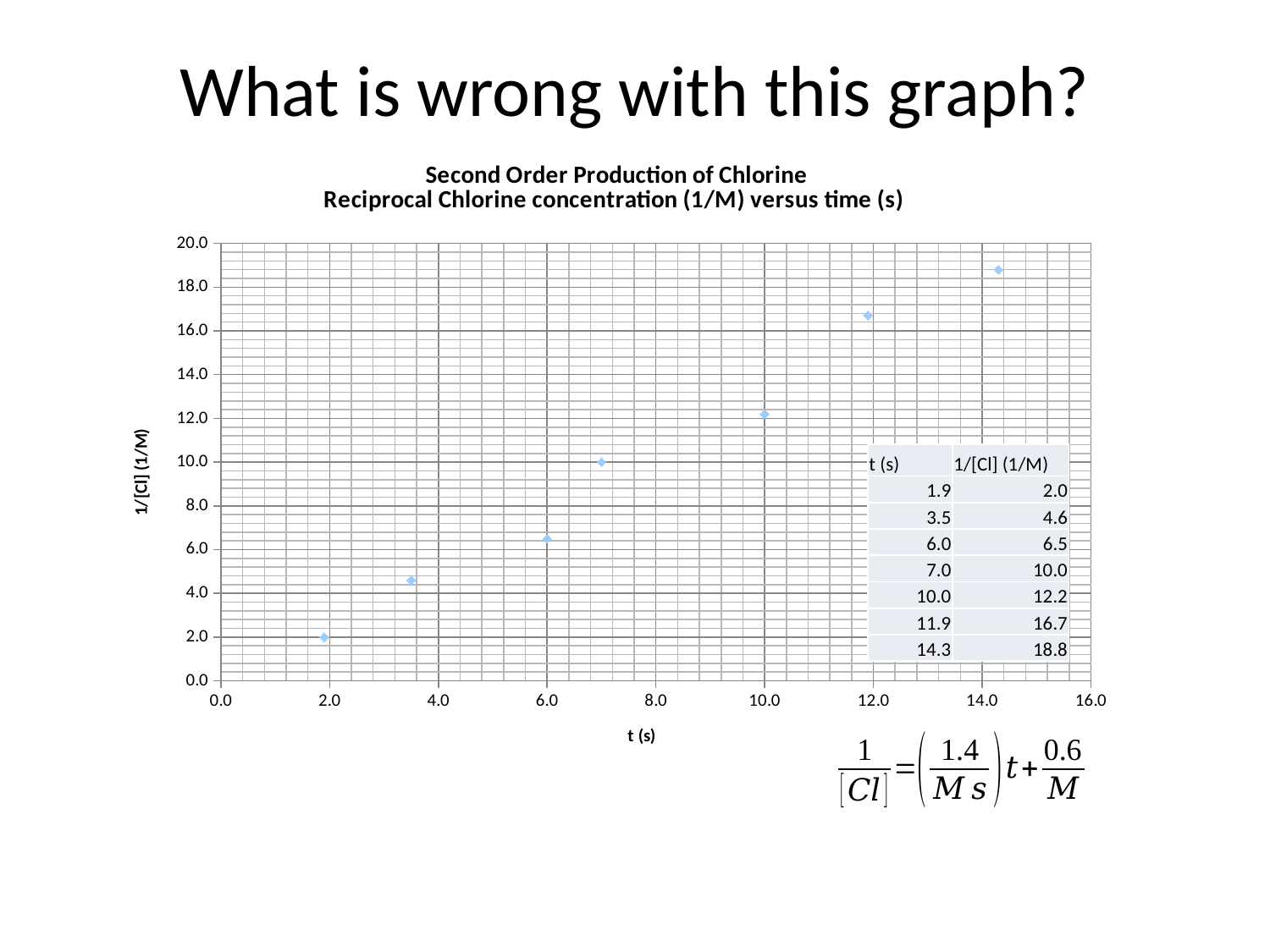
How many data points are plotted on the chart? 7 What is the value of 1/[Cl] (1/M) at t = 14.3 s? 18.8 At which time t (s) is 1/[Cl] lowest? 1.9 At which time t (s) is 1/[Cl] highest? 14.3 What is the difference in 1/[Cl] (1/M) between t = 11.9 s and t = 10.0 s? 4.5 What is the label of the x axis of the chart? t (s) Is the value of 1/[Cl] at t = 11.9 s greater or less than 14.0? greater What is the value of 1/[Cl] (1/M) at t = 3.5 s? 4.6 Which has a larger 1/[Cl] value: t = 6.0 s or t = 7.0 s? t = 7.0 s Do the 1/[Cl] values rise or fall as t increases along the x axis? rise What is the value of 1/[Cl] (1/M) at t = 7.0 s? 10.0 What kind of chart is shown on the slide? scatter chart